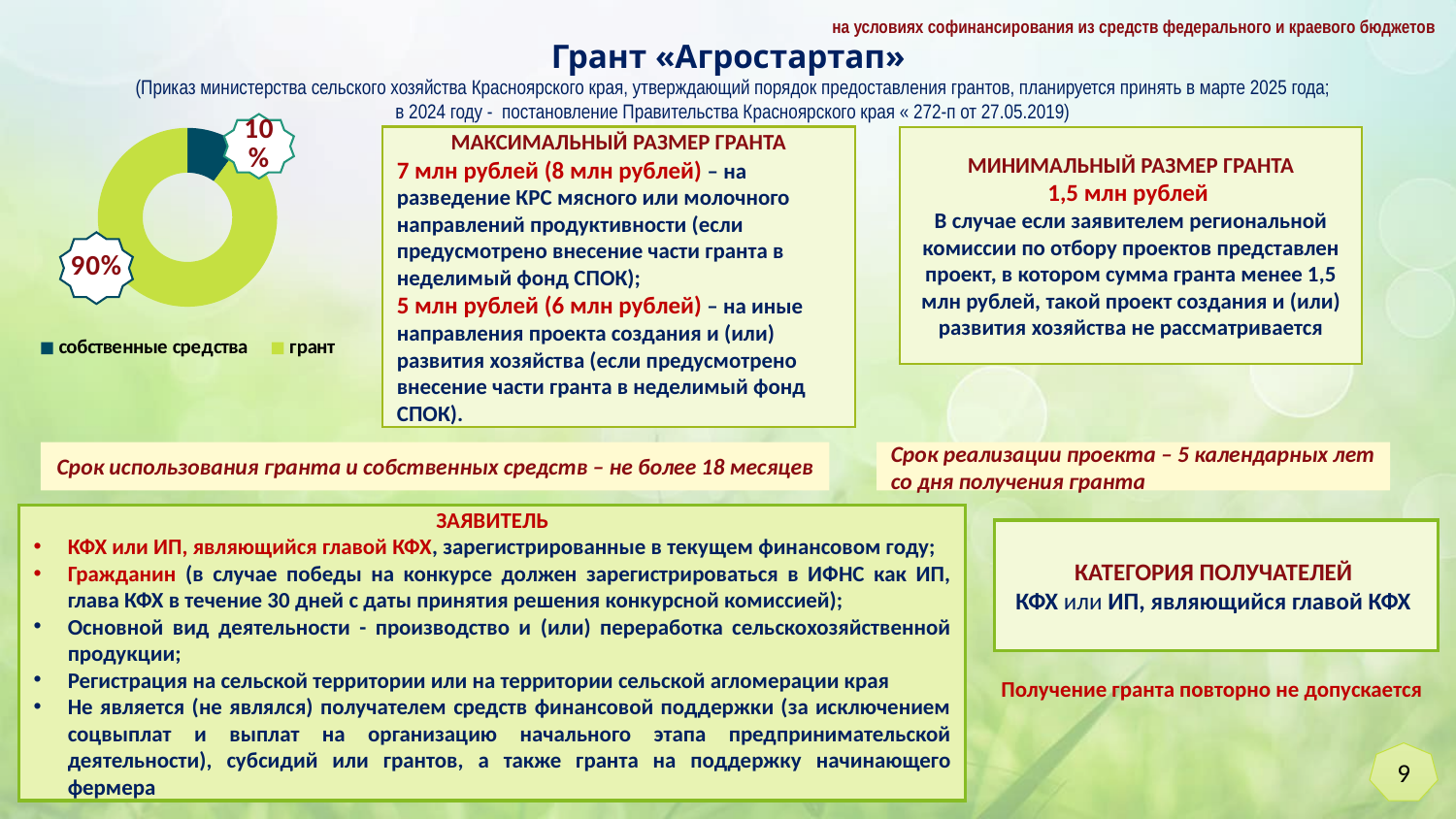
In the doughnut chart, which is larger: «грант» or «собственные средства»? грант What value is shown for «собственные средства» in the doughnut chart? 10% What share of the doughnut chart does «собственные средства» take? 10% What value is shown for «грант» in the doughnut chart? 90% How many categories does the doughnut chart show? 2 What kind of chart is shown on the left of the slide? doughnut (pie) chart What is the difference between the «грант» and «собственные средства» shares in the doughnut chart? 80% Which category has the smallest slice in the doughnut chart? собственные средства Which category has the largest slice in the doughnut chart? грант What colour is the «грант» slice in the doughnut chart? light green What share of the doughnut chart does «грант» take? 90% How many entries does the legend of the doughnut chart list? 2